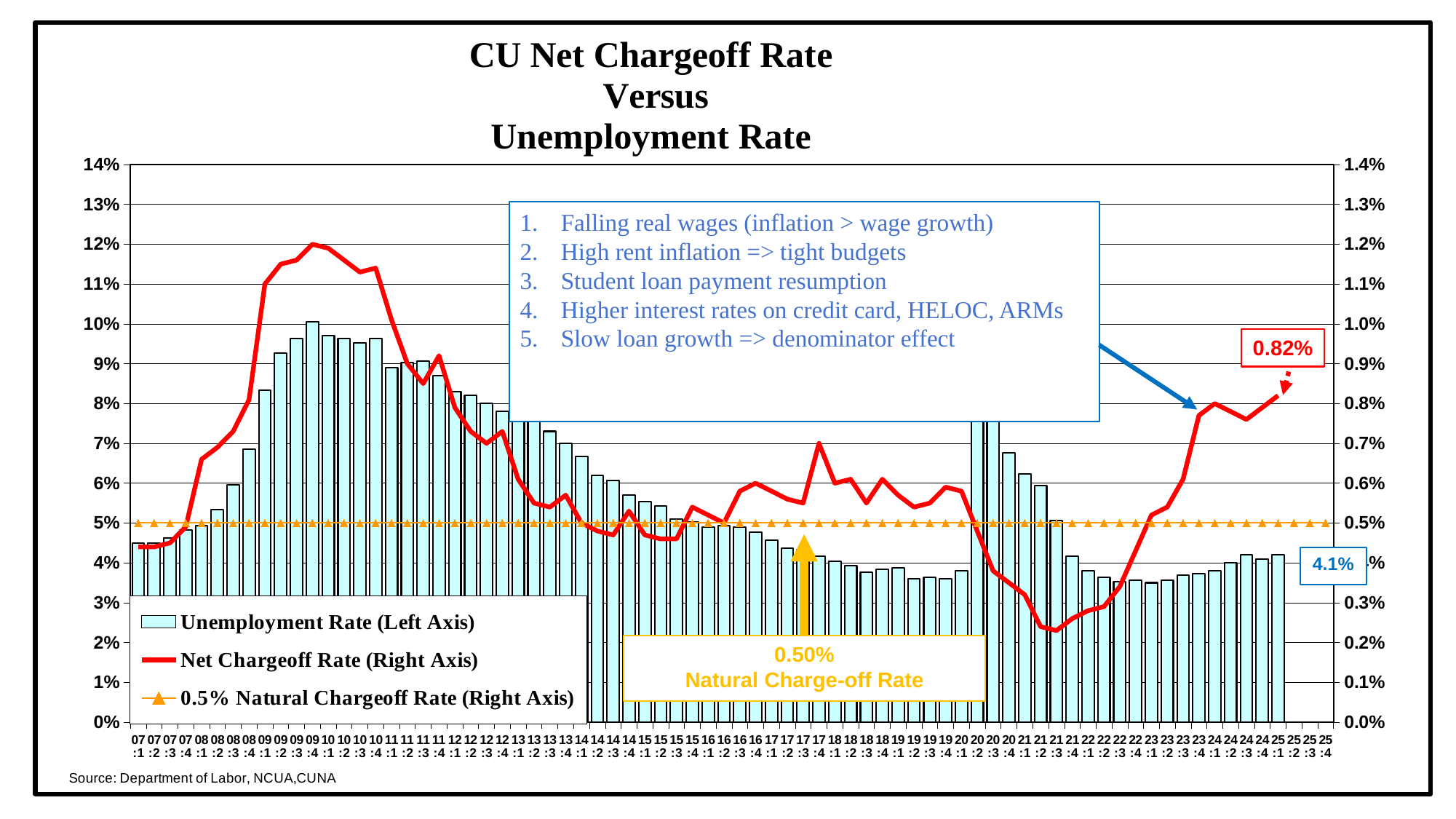
Does the net chargeoff rate rise or fall from 21:2 to 25:1? rise Is the net chargeoff rate for 21:2 greater or less than 0.3%? less What is the latest unemployment rate value labeled on the chart? 4.1% Is the net chargeoff rate for 09:4 greater or less than 1.1%? greater By how much does the labeled latest net chargeoff rate of 0.82% exceed the 0.50% natural charge-off rate? 0.32% How many series does the legend list? 3 What kind of chart is this? Combined bar and line chart What is the latest net chargeoff rate value labeled on the chart? 0.82% In which quarter does the net chargeoff rate reach its highest point? 09:4 Is the unemployment rate for 10:1 greater or less than 9%? greater What is the natural charge-off rate shown on the chart? 0.50% What is the title of the chart? CU Net Chargeoff Rate Versus Unemployment Rate